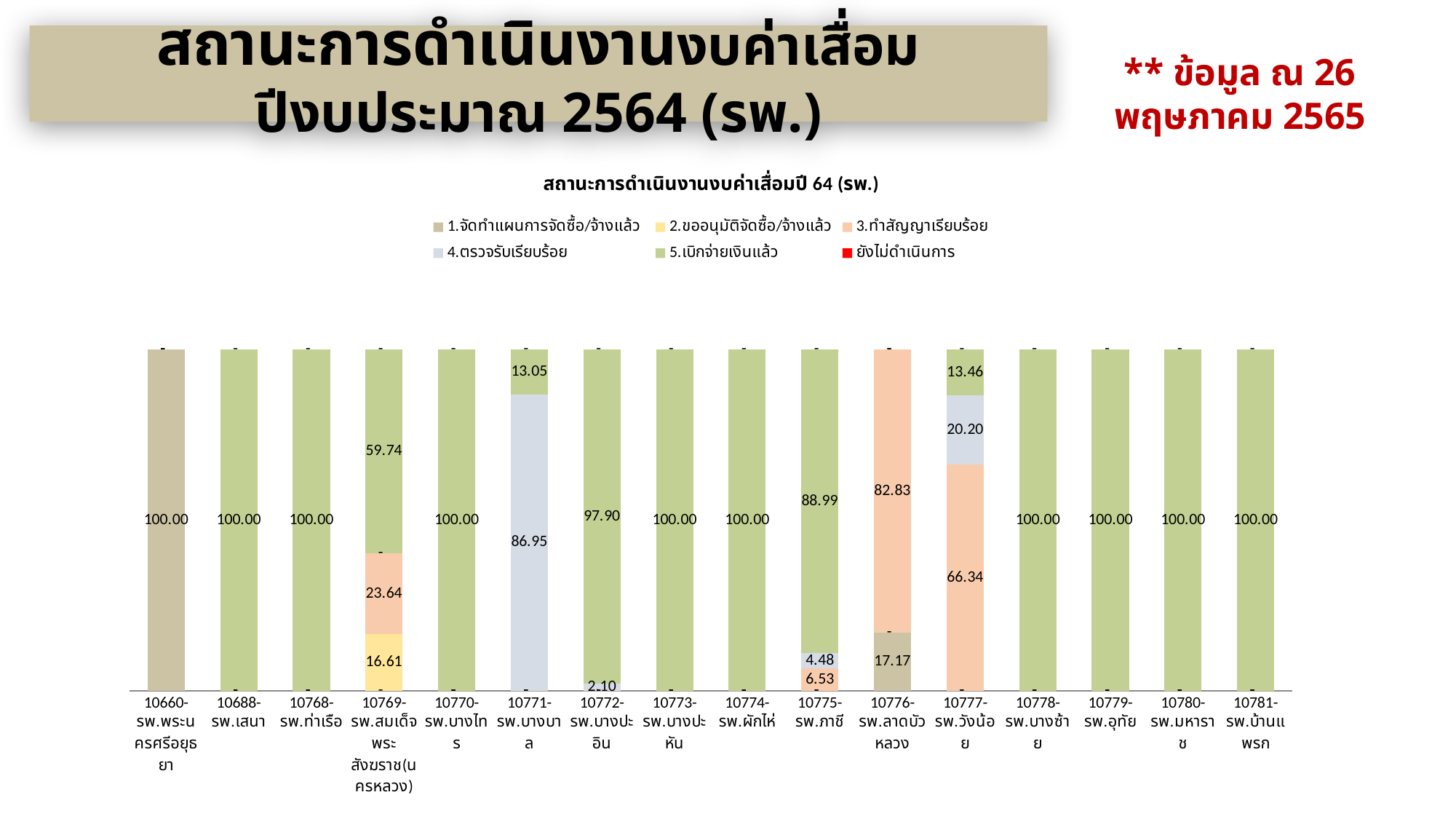
What is the value of the 2.ขออนุมัติจัดซื้อ/จ้างแล้ว segment for 10769-รพ.สมเด็จพระสังฆราช(นครหลวง)? 16.61 What is the value of the 1.จัดทำแผนการจัดซื้อ/จ้างแล้ว segment for 10776-รพ.ลาดบัวหลวง? 17.17 What is the total of the stacked bar for 10777-รพ.วังน้อย? 100.00 Which is larger: the 5.เบิกจ่ายเงินแล้ว segment for 10771-รพ.บางบาล or for 10772-รพ.บางปะอิน? 10772-รพ.บางปะอิน What is the value of the 3.ทำสัญญาเรียบร้อย segment for 10776-รพ.ลาดบัวหลวง? 82.83 What kind of chart is shown on the slide? stacked bar chart How many series does the chart's legend list? 6 What is the value of the 5.เบิกจ่ายเงินแล้ว segment for 10769-รพ.สมเด็จพระสังฆราช(นครหลวง)? 59.74 How many hospitals (categories) are shown along the x axis of the chart? 16 What is the value of the 4.ตรวจรับเรียบร้อย segment for 10771-รพ.บางบาล? 86.95 What is the title of the chart? สถานะการดำเนินงานงบค่าเสื่อมปี 64 (รพ.) What is the difference between the 3.ทำสัญญาเรียบร้อย segment (66.34) and the 4.ตรวจรับเรียบร้อย segment (20.20) for 10777-รพ.วังน้อย? 46.14